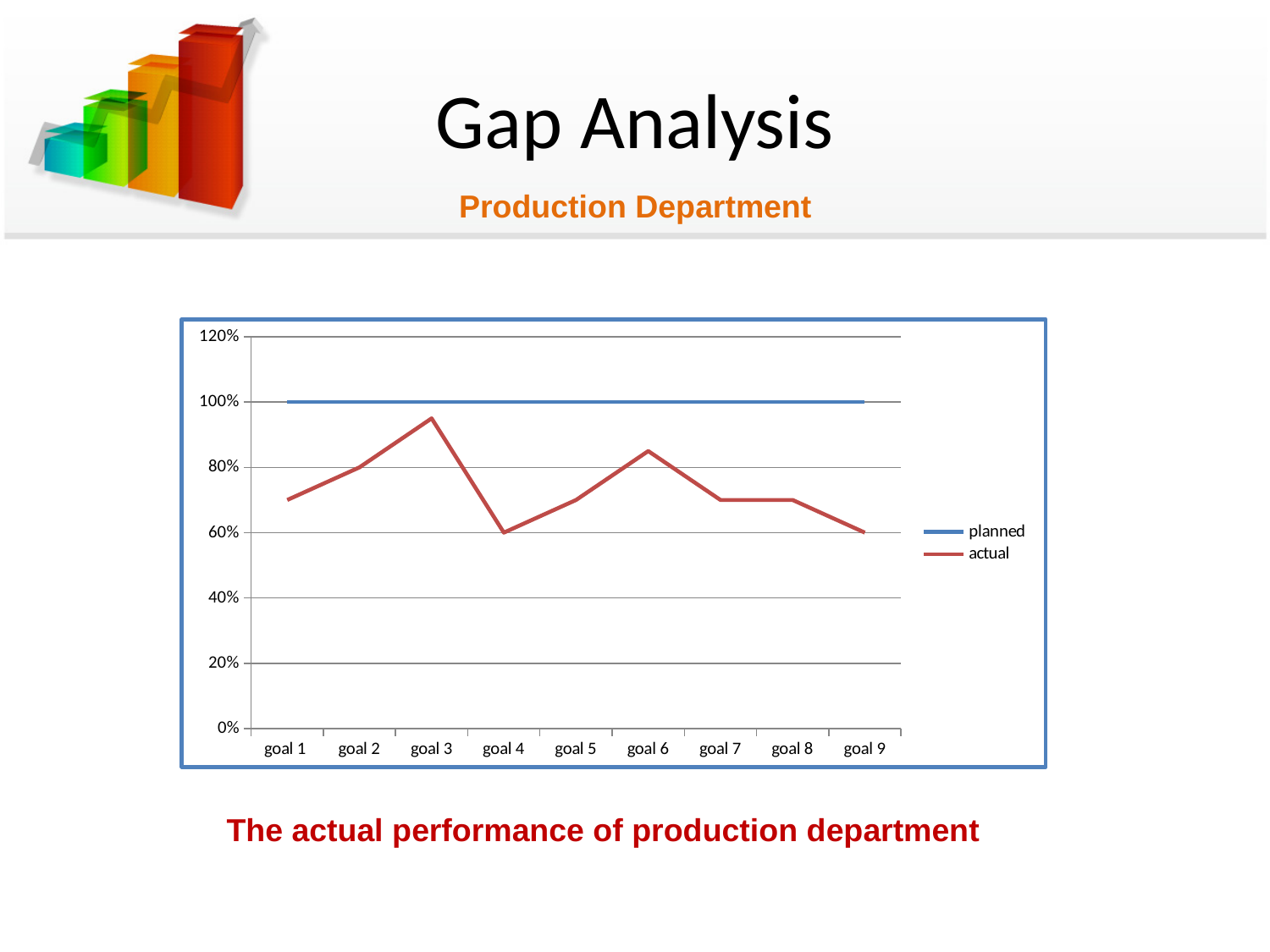
Is the actual value for goal 1 greater or less than 80%? less What is the actual value for goal 9? 60% Does the actual line rise or fall from goal 6 to goal 9? fall Is the actual value for goal 6 greater or less than 80%? greater For which goal is the actual value highest? goal 3 What is the planned value for goal 5? 100% How many series does the legend list? 2 How many goals are shown along the x axis? 9 Which has the larger actual value, goal 3 or goal 6? goal 3 What is the actual value for goal 4? 60% What are the two entries in the legend? planned and actual What kind of chart is shown on the slide? line chart